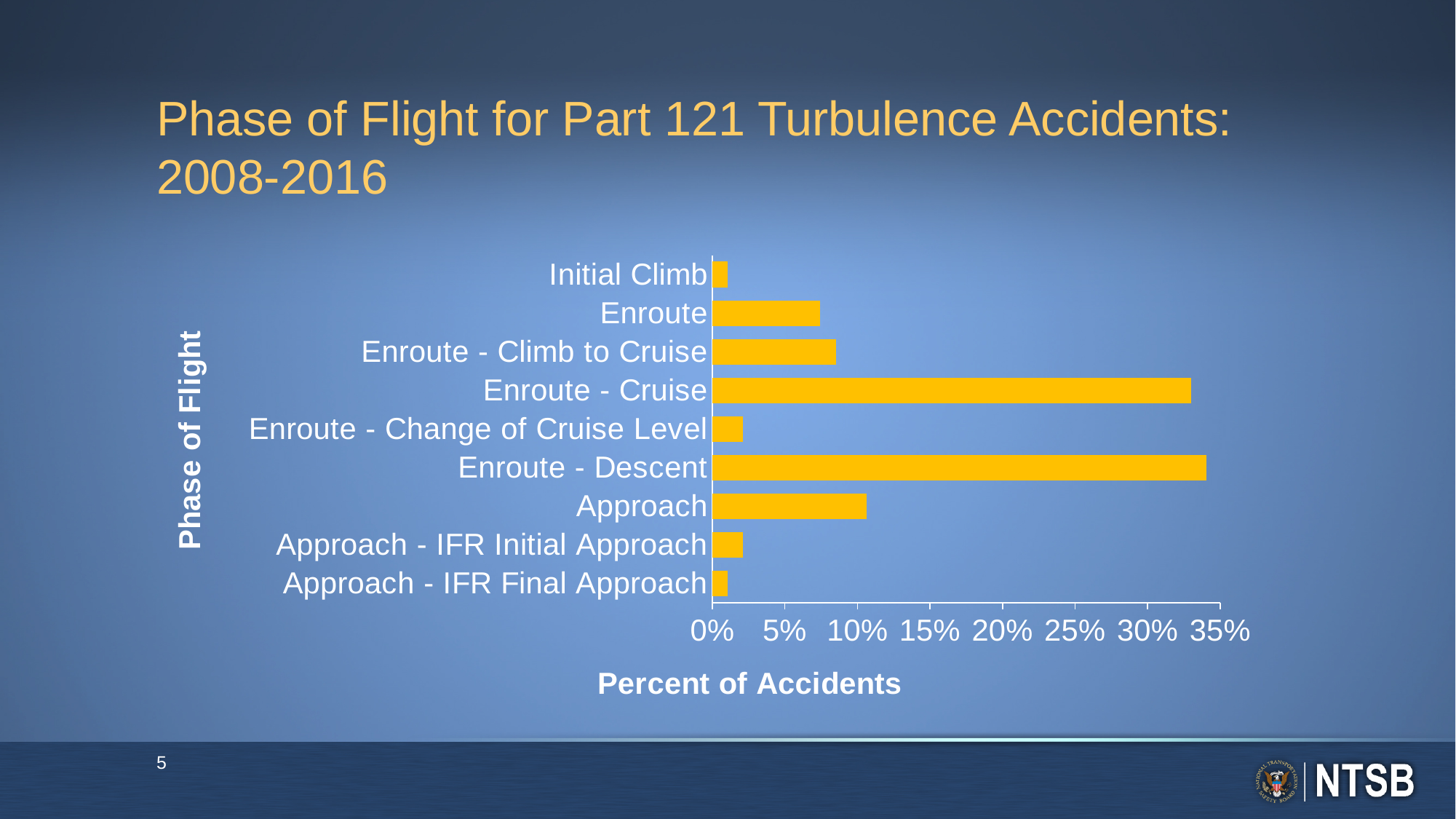
Which has a larger value, Enroute or Initial Climb? Enroute Is the value for Approach greater or less than 15%? less What is the label of the horizontal axis? Percent of Accidents Is the value for Enroute - Climb to Cruise greater or less than 10%? less What is the title of the chart? Phase of Flight for Part 121 Turbulence Accidents: 2008-2016 What kind of chart is shown on the slide? bar chart Is the value for Enroute - Change of Cruise Level greater or less than 5%? less Which has a larger value, Enroute - Cruise or Approach? Enroute - Cruise How many phases of flight are plotted in the chart? 9